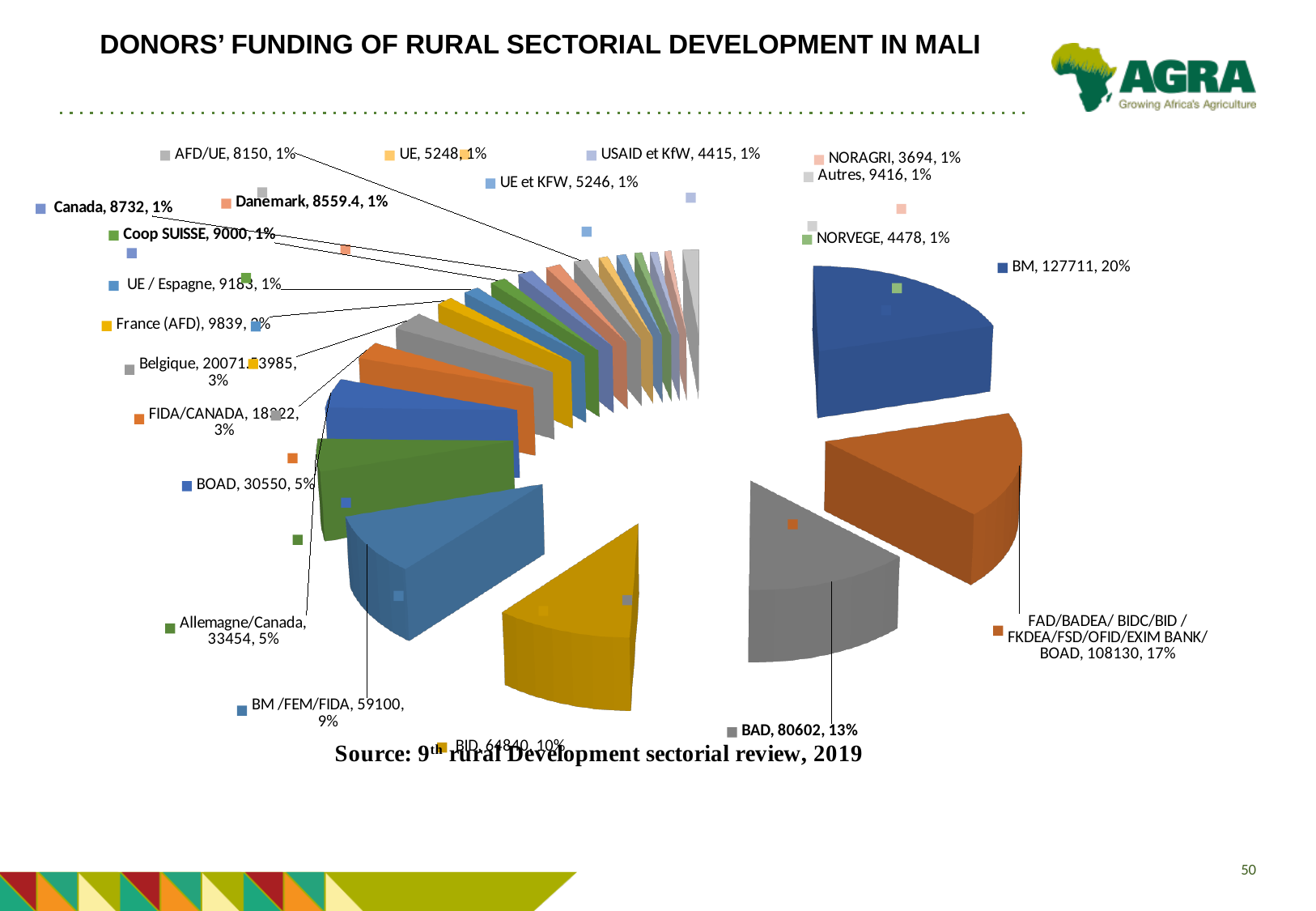
Which has the larger funding value, BOAD or Allemagne/Canada? Allemagne/Canada What is the funding value shown for BM /FEM/FIDA? 59100 What kind of chart is shown on the slide? pie chart What share of the pie does BM account for? 20% Which donor has the smallest funding value in the pie chart? NORAGRI What share of the pie does BAD account for? 13% What is the funding value shown for BAD? 80602 Which donor has the largest funding value in the pie chart? BM What is the funding value shown for BOAD? 30550 What is the difference between the funding values for BM and BAD? 47109 What is the funding value shown for BM? 127711 What is the title of the chart on the slide? DONORS' FUNDING OF RURAL SECTORIAL DEVELOPMENT IN MALI